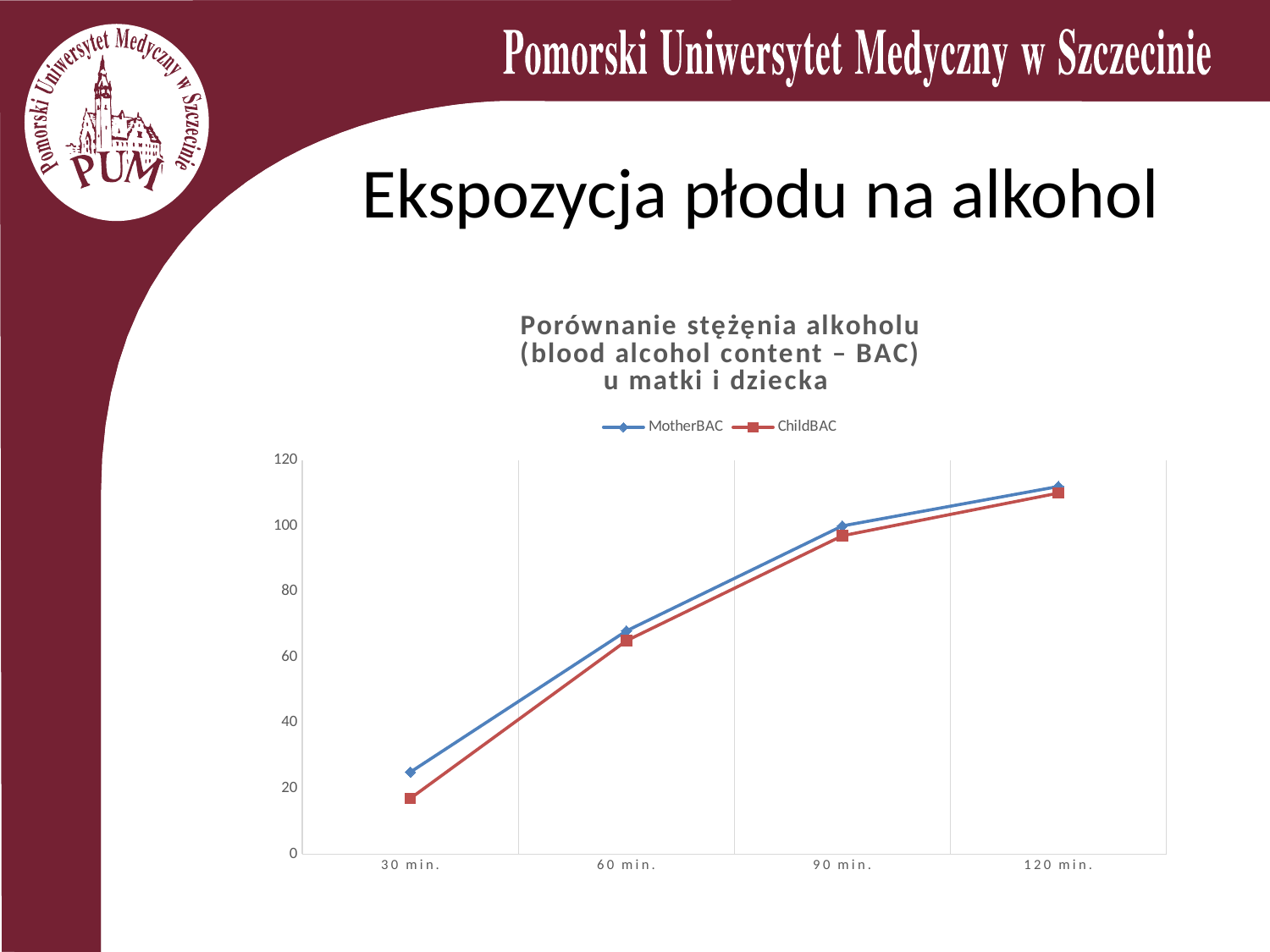
How many time points are plotted along the x axis? 4 At which time point is the ChildBAC value lowest? 30 min. How many series does the chart legend list? 2 Is the ChildBAC value at 60 min. greater or less than 80? less At 30 min., which series has the higher value, MotherBAC or ChildBAC? MotherBAC What kind of chart is shown on the slide? line chart Do the MotherBAC values rise or fall from 30 min. to 120 min.? rise Is the MotherBAC value at 60 min. greater or less than 60? greater Is the ChildBAC value at 30 min. greater or less than 40? less Which series is drawn in red? ChildBAC